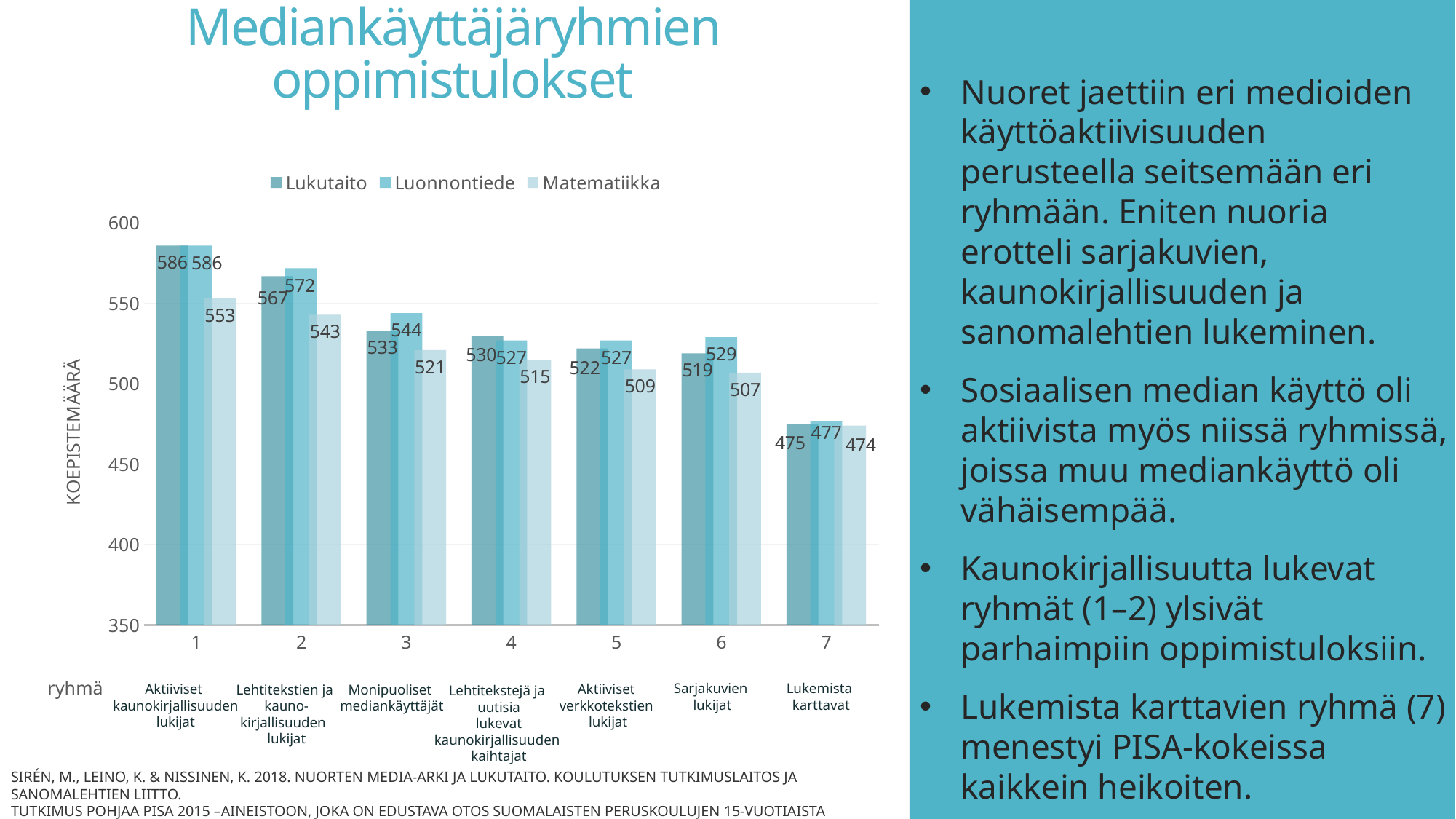
How many series does the legend list? 3 Which is larger: the Luonnontiede value for group 3 or the Luonnontiede value for group 4? group 3 How many groups are shown on the x axis? 7 What is the Lukutaito value for group 1? 586 What is the Matematiikka value for group 2? 543 What is the Luonnontiede value for group 6? 529 Do the Matematiikka values rise or fall from group 1 to group 7? fall What kind of chart is shown? bar chart Which group has the highest Luonnontiede value? 1 What is the label of the y axis? KOEPISTEMÄÄRÄ What is the difference between the Lukutaito values for group 1 and group 7? 111 Which group has the lowest Matematiikka value? 7